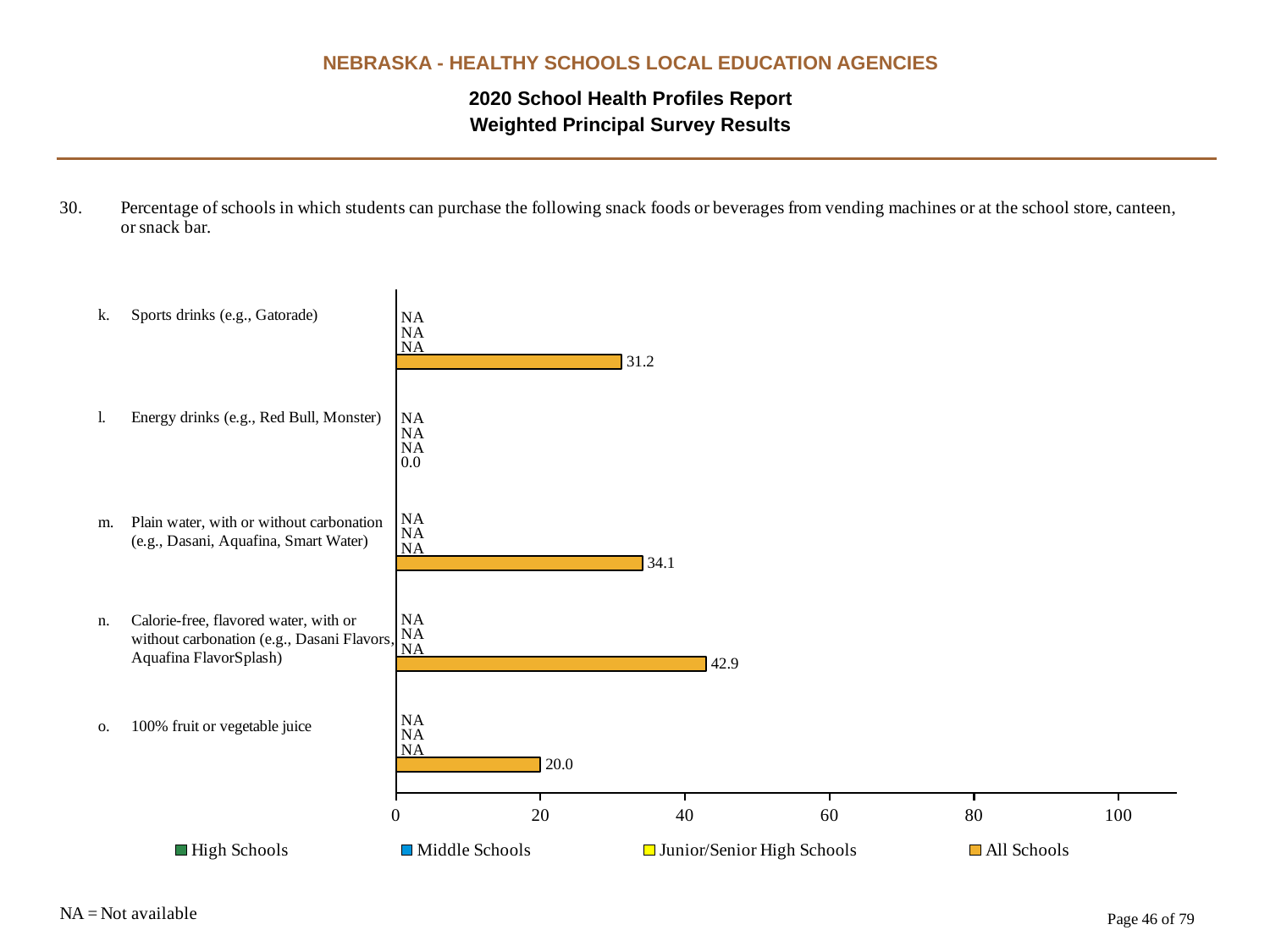
What is the All Schools value for Plain water, with or without carbonation? 34.1 What kind of chart is shown on the slide? Bar chart What is the All Schools value for 100% fruit or vegetable juice? 20.0 What is the difference between the All Schools values for Calorie-free, flavored water and 100% fruit or vegetable juice? 22.9 How many series does the legend list? 4 What is the All Schools value for Calorie-free, flavored water, with or without carbonation? 42.9 Which has a larger All Schools value: Sports drinks or Plain water? Plain water Which category has the lowest All Schools value? Energy drinks (e.g., Red Bull, Monster) How many categories are shown on the chart? 5 What is the All Schools value for Energy drinks (e.g., Red Bull, Monster)? 0.0 Which category has the highest All Schools value? Calorie-free, flavored water, with or without carbonation What is the All Schools value for Sports drinks (e.g., Gatorade)? 31.2